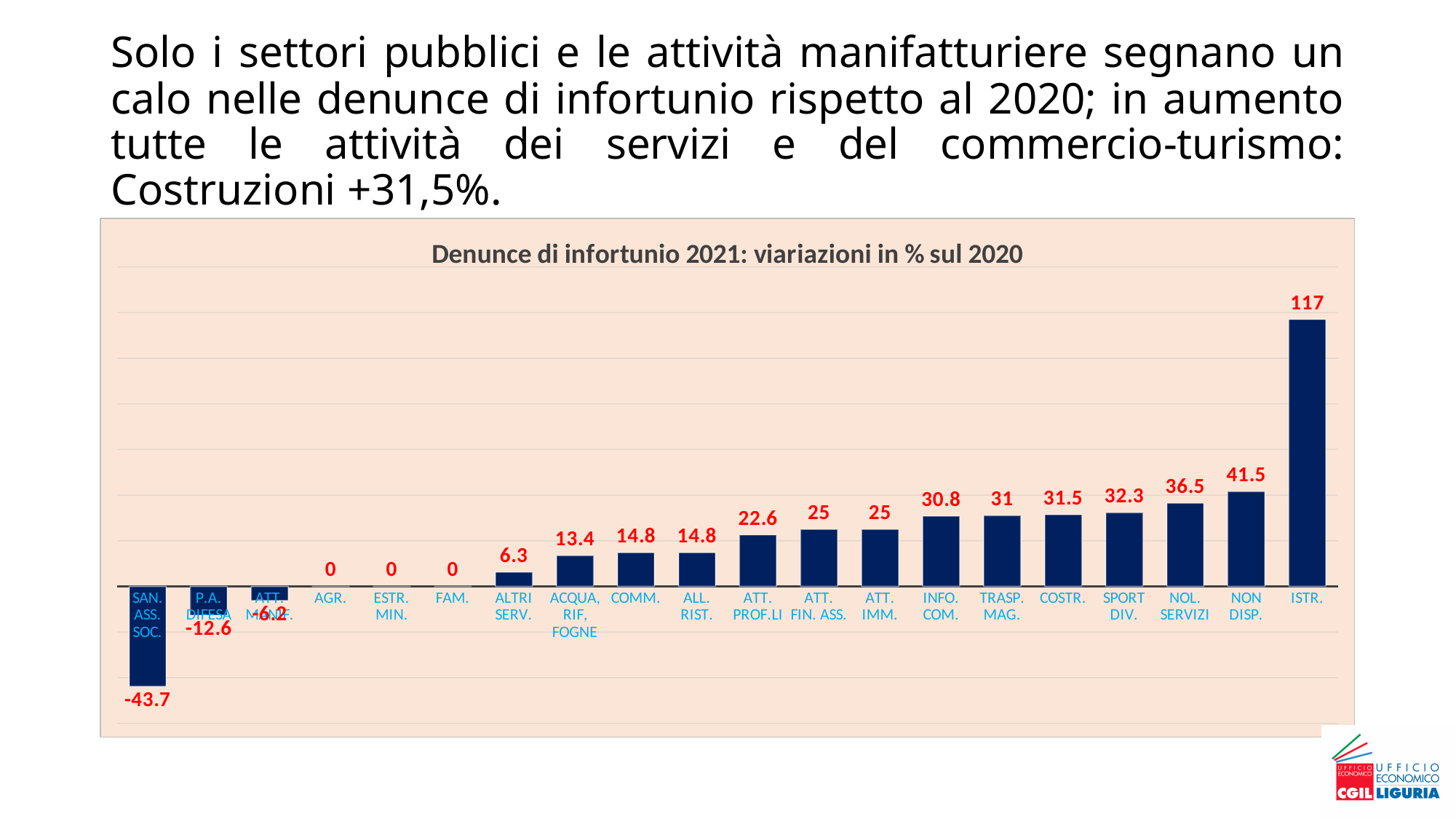
How many categories are shown on the x axis? 20 What is the value for COSTR.? 31.5 Which is larger, the value for SPORT DIV. or the value for ATT. PROF.LI? SPORT DIV. What is the value for SAN. ASS. SOC.? -43.7 What type of chart is shown on the slide? bar chart Do the values generally rise or fall from left to right along the x axis? rise Which category has the highest value? ISTR. Which category has the lowest value? SAN. ASS. SOC. What is the difference between the values for ISTR. and NON DISP.? 75.5 What is the title of the chart? Denunce di infortunio 2021: viariazioni in % sul 2020 What is the value for ISTR.? 117 What is the value for NOL. SERVIZI? 36.5